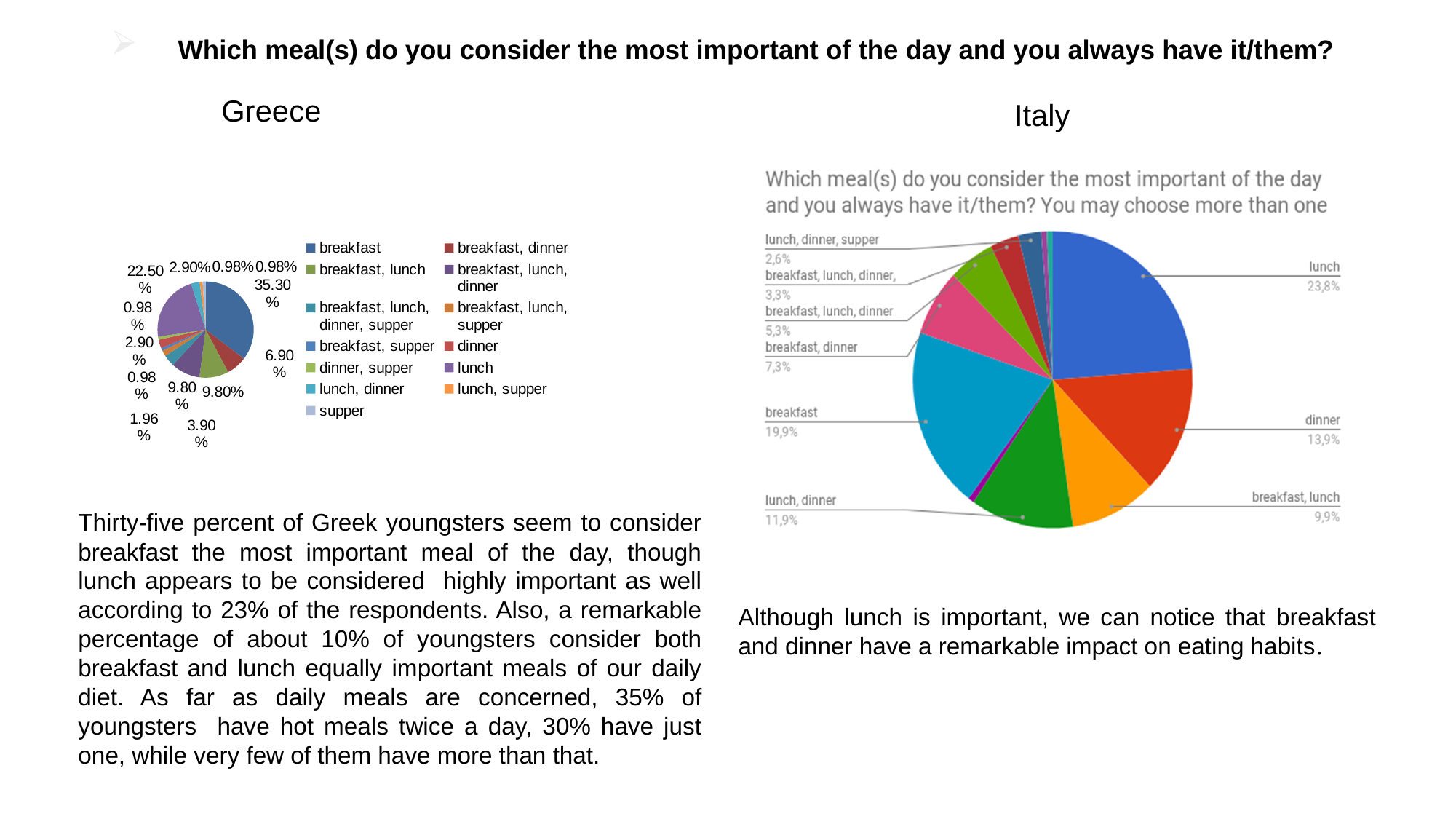
In the Italy pie chart, what percentage is shown for lunch? 23,8% In the Italy pie chart, what percentage is shown for breakfast? 19,9% What type of chart is used for Greece? pie chart In the Greece pie chart, what percentage is shown for breakfast? 35.30% In the Greece pie chart, which meal option has the largest share? breakfast In the Italy pie chart, which has the larger share: dinner or 'lunch, dinner'? dinner In the Italy pie chart, what percentage is shown for 'breakfast, lunch'? 9,9% In the Italy pie chart, what percentage is shown for dinner? 13,9% In the Italy pie chart, which meal option has the largest share? lunch In the Greece pie chart, what percentage is shown for lunch? 22.50% In the Italy pie chart, what is the difference between the shares for lunch and breakfast? 3,9% How many entries does the legend of the Greece chart list? 13